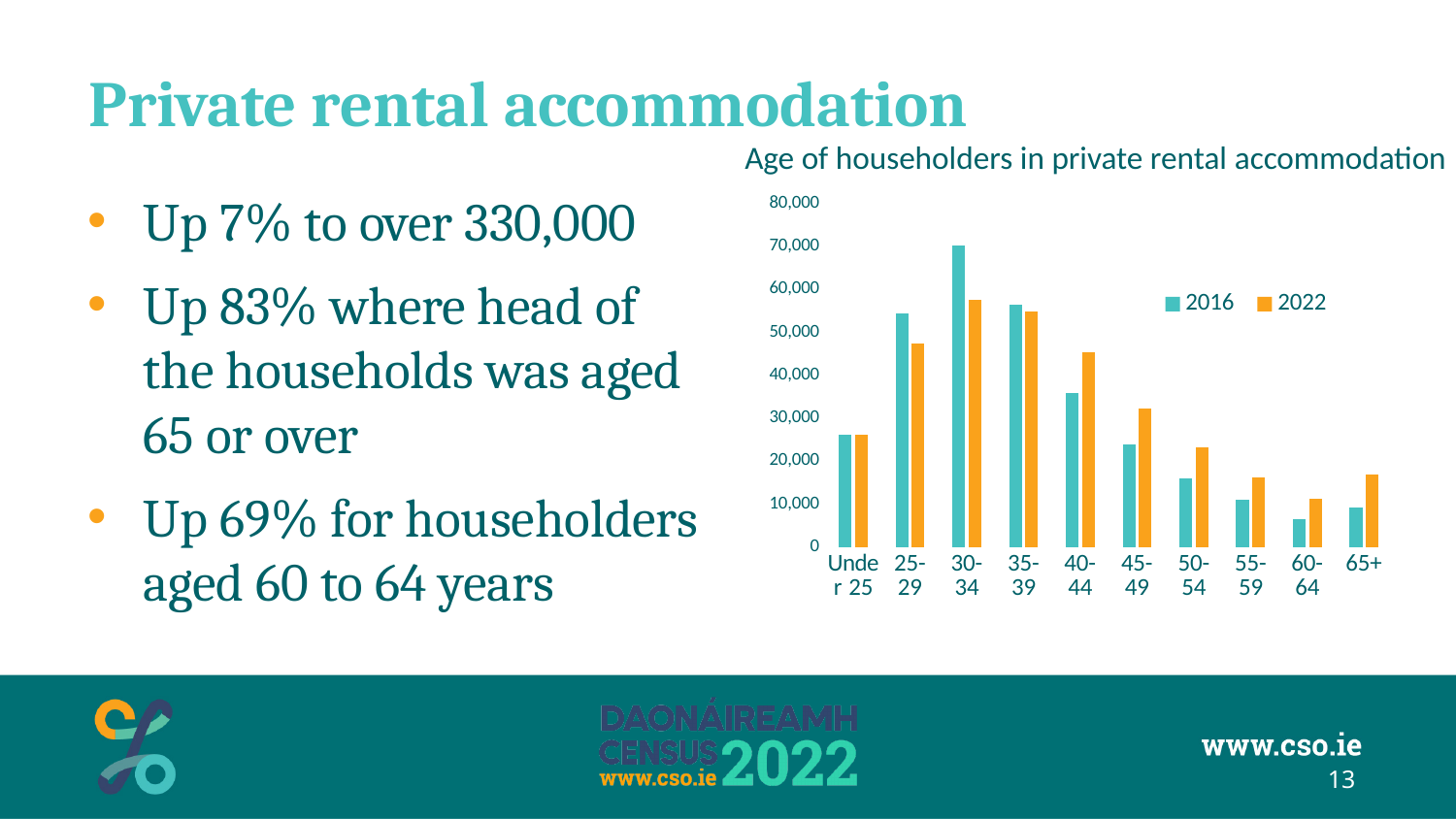
Is the 2016 value for the 30-34 age group greater or less than 60,000? greater What kind of chart is shown on the slide? Bar chart Which age group has the highest value for 2016? 30-34 Is the 2022 value for the 65+ age group greater or less than 10,000? greater Is the 2016 value for the 60-64 age group greater or less than 10,000? less For the 40-44 age group, which year has the larger value, 2016 or 2022? 2022 For the 30-34 age group, which year has the larger value, 2016 or 2022? 2016 Which age group has the highest value for 2022? 30-34 How many age categories are shown on the x axis of the chart? 10 Which age group has the lowest value for 2016? 60-64 What is the title of the chart? Age of householders in private rental accommodation How many series does the chart legend list? 2